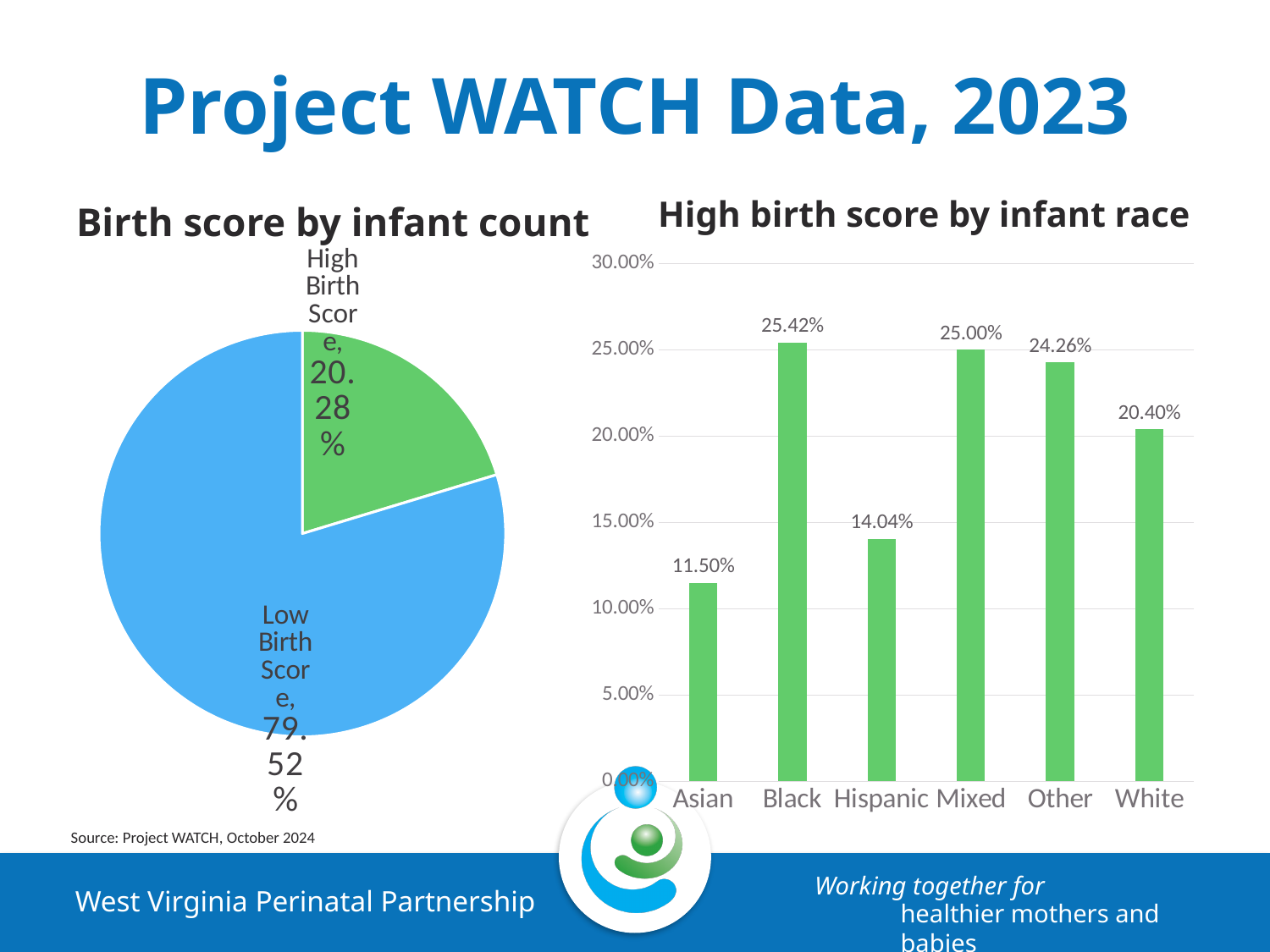
How many race categories are shown in the 'High birth score by infant race' chart? 6 In the 'High birth score by infant race' chart, what is the difference between the values for Mixed and Hispanic? 10.96% What kind of chart is 'High birth score by infant race'? Bar chart In the 'High birth score by infant race' chart, what is the value for Black? 25.42% In the 'High birth score by infant race' chart, what is the value for White? 20.40% In the 'Birth score by infant count' pie chart, what share is labelled High Birth Score? 20.28% In the 'High birth score by infant race' chart, which is larger, the value for Other or the value for White? Other In the 'High birth score by infant race' chart, what is the value for Asian? 11.50% In the 'Birth score by infant count' pie chart, what share is labelled Low Birth Score? 79.52% What kind of chart is 'Birth score by infant count'? Pie chart In the 'High birth score by infant race' chart, which race has the highest value? Black In the 'High birth score by infant race' chart, which race has the lowest value? Asian